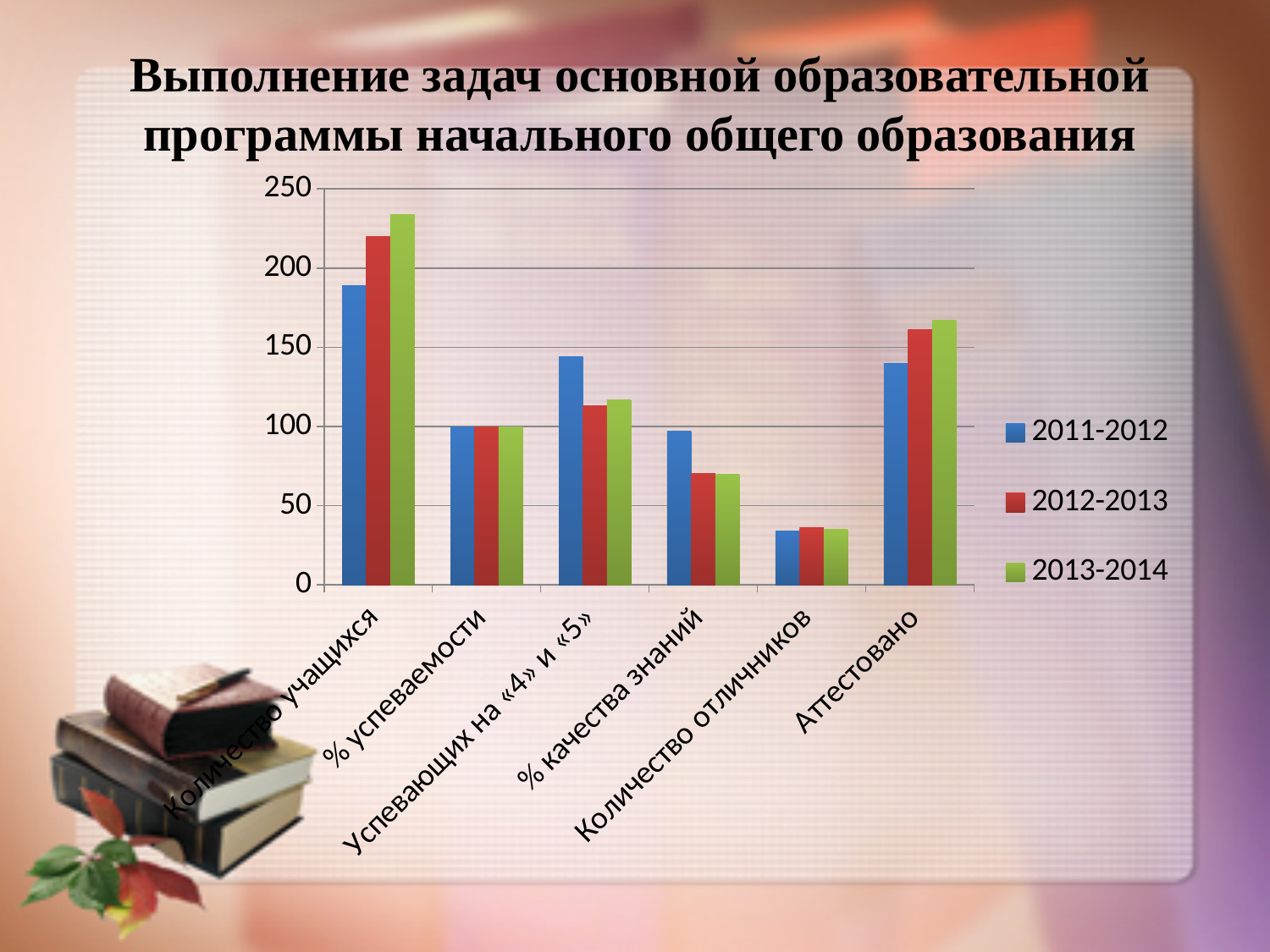
Is the value for Аттестовано in 2011-2012 greater or less than 150? less Which is larger for Успевающих на «4» и «5»: the 2011-2012 value or the 2012-2013 value? 2011-2012 Do the values for Количество учащихся rise or fall from 2011-2012 to 2013-2014? rise Which category has the lowest bars in the chart? Количество отличников How many series does the legend list? 3 Which series is shown in green in the legend? 2013-2014 Which category has the tallest bar in the chart? Количество учащихся Is the value for Количество учащихся in 2013-2014 greater or less than 200? greater Is the value for Количество отличников in 2012-2013 greater or less than 50? less What is the value for % успеваемости in 2011-2012? 100 What kind of chart is shown on the slide? bar chart How many categories are shown on the x axis? 6